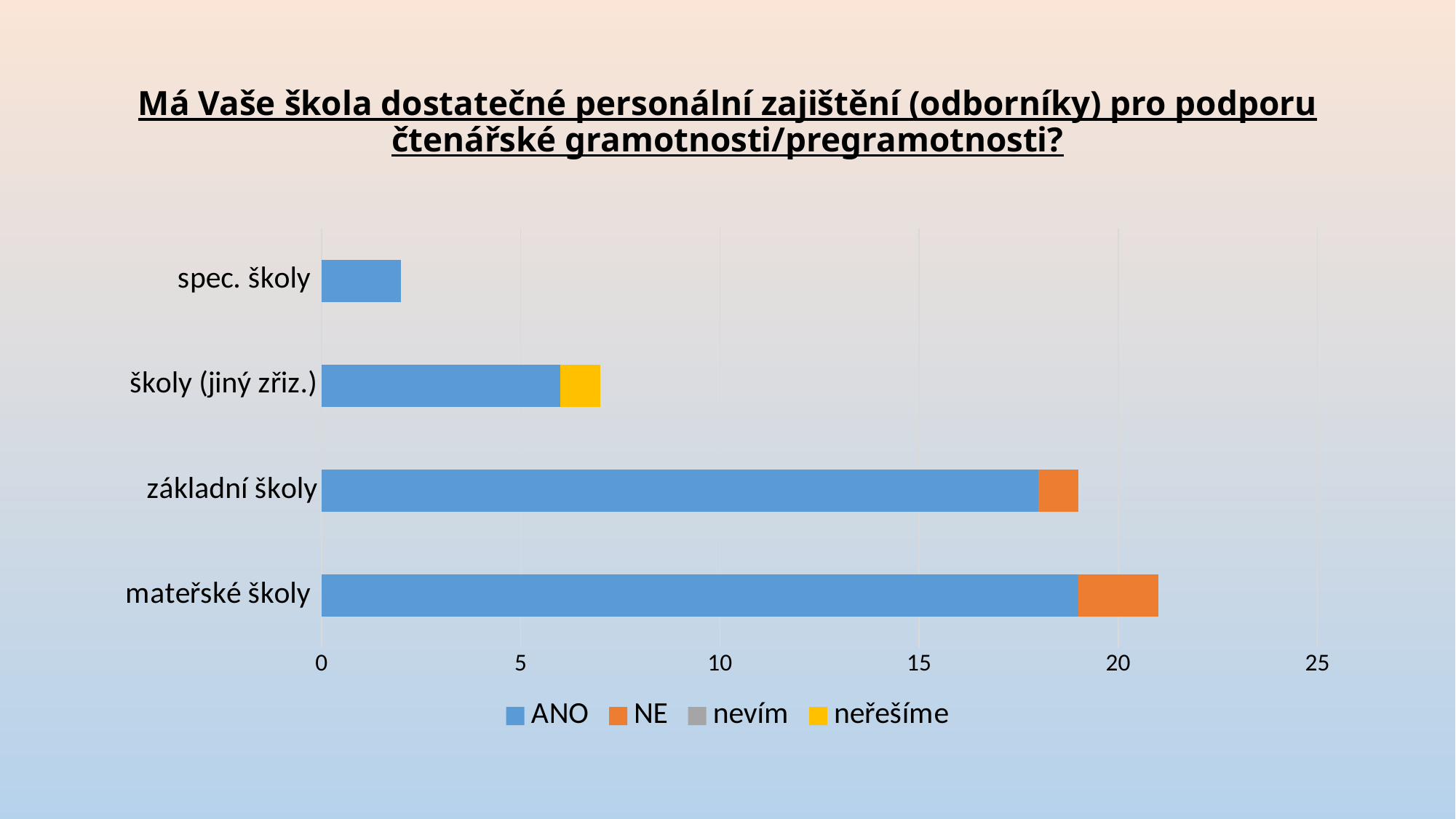
How many categories (school types) are shown on the chart? 4 What kind of chart is shown on the slide? bar chart Which category has the longest total bar? mateřské školy Is the total bar for mateřské školy greater or less than 20? greater Is the total bar for školy (jiný zřiz.) greater or less than 5? greater How many series does the legend list? 4 Which category is the only one with a yellow (neřešíme) segment? školy (jiný zřiz.) Which legend entry is shown in yellow? neřešíme Is the value for spec. školy greater or less than 5? less Which has a longer total bar, mateřské školy or školy (jiný zřiz.)? mateřské školy Which category has the shortest total bar? spec. školy